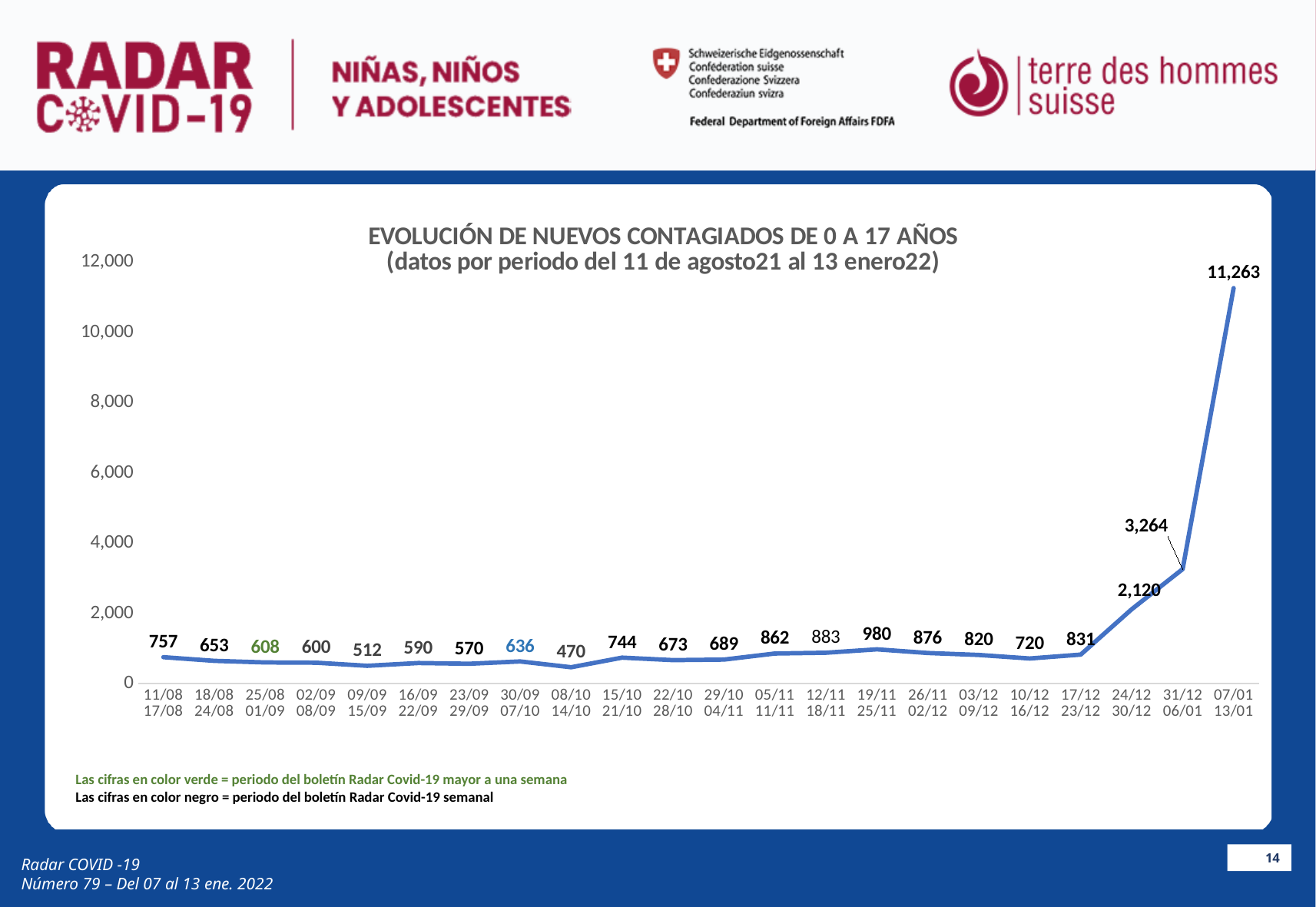
Which period has the lowest value? 08/10–14/10 What is the difference between the values for 07/01–13/01 and 31/12–06/01? 7,999 What is the difference between the values for 11/08–17/08 and 18/08–24/08? 104 What is the value for the period 19/11–25/11? 980 Which is larger, the value for 15/10–21/10 or the value for 22/10–28/10? 15/10–21/10 Which data label is shown in green? 608 What is the value for the period 08/10–14/10? 470 What is the value for the period 07/01–13/01? 11,263 How many periods are plotted on the x axis? 22 Which period has the highest value? 07/01–13/01 What type of chart is shown on the slide? line chart What is the value for the period 24/12–30/12? 2,120